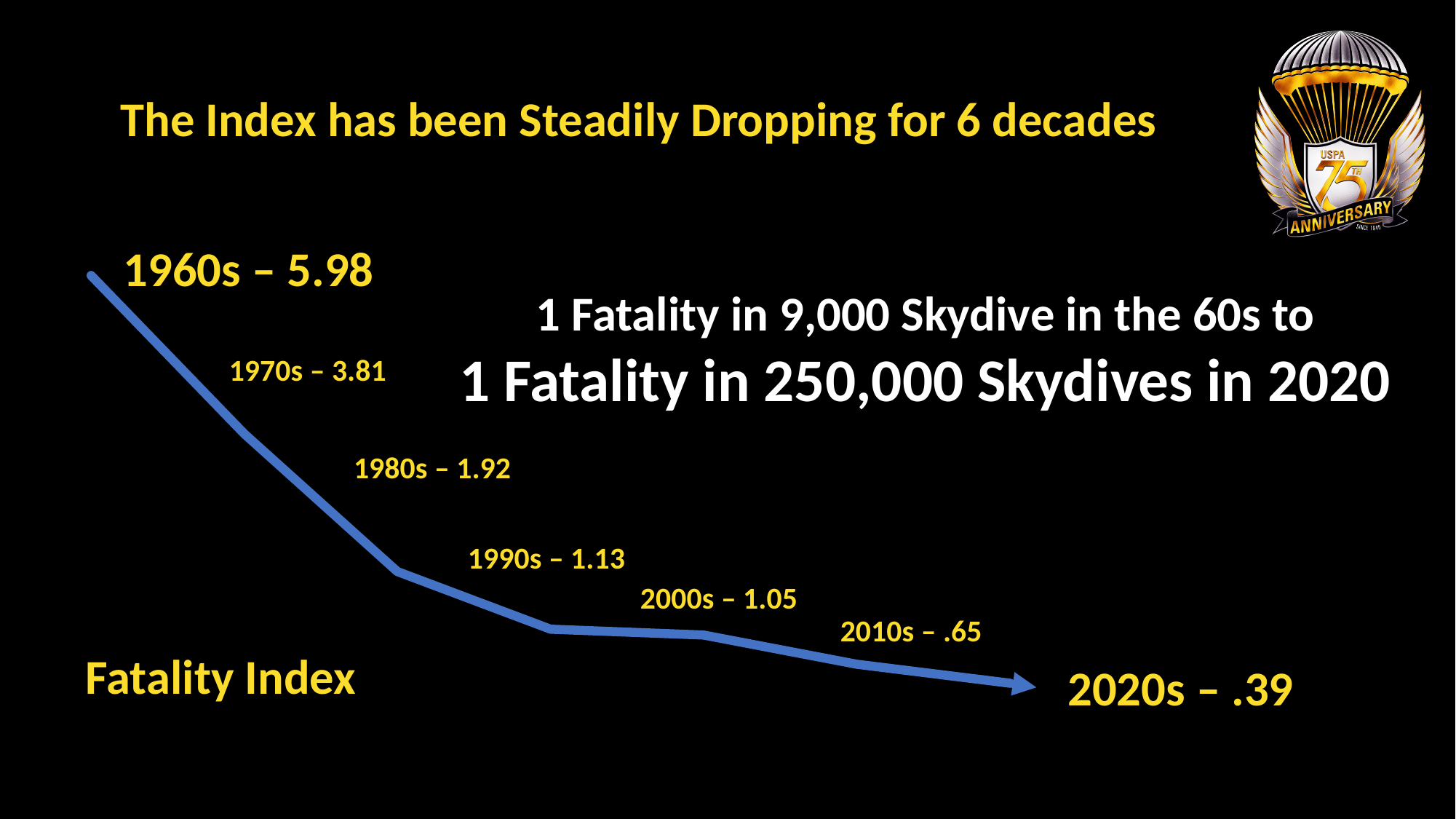
Which is larger, the Fatality Index for the 1990s or the 2000s? 1990s What is the Fatality Index value for the 1980s? 1.92 Which decade has the highest Fatality Index? 1960s How many decades are plotted on the Fatality Index chart? 7 Does the Fatality Index rise or fall from the 1960s to the 2020s? Fall What is the difference between the Fatality Index for the 1960s and the 2020s? 5.59 What is the Fatality Index value for the 2010s? .65 Which decade has the lowest Fatality Index? 2020s What kind of chart is shown on the slide? Line chart What is the difference between the Fatality Index for the 1960s and the 1970s? 2.17 What is the Fatality Index value for the 1960s? 5.98 What is the Fatality Index value for the 2020s? .39